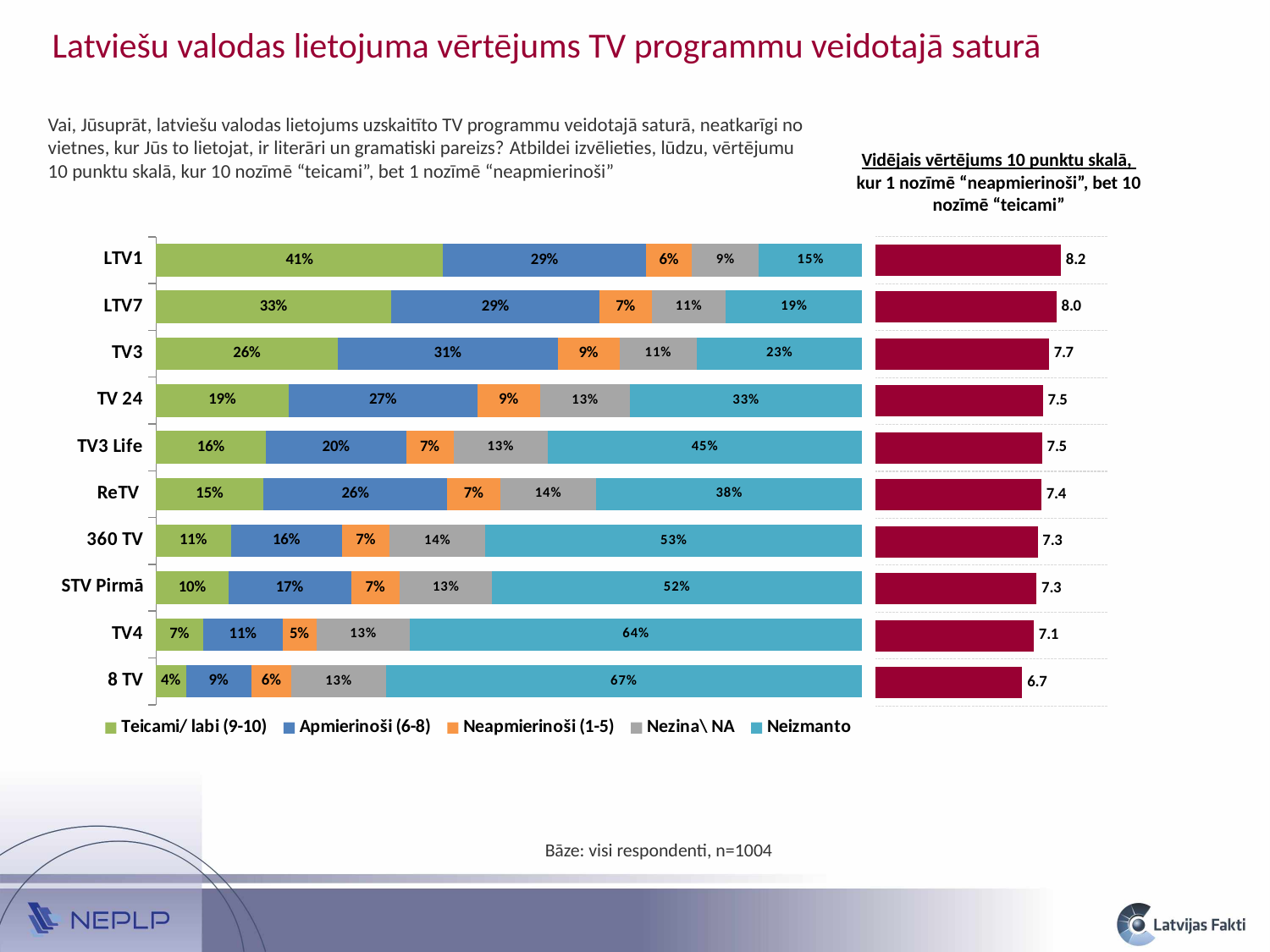
How many series does the legend of the stacked bar chart list? 5 In the stacked bar chart, what percentage of respondents rated LTV1 as "Teicami/ labi (9-10)"? 41% In the right-hand chart of average ratings, which channel has the highest average rating? LTV1 In the stacked bar chart, which legend entry is shown in orange? Neapmierinoši (1-5) In the stacked bar chart, which channel has the larger "Neizmanto" share, TV4 or 8 TV? 8 TV In the right-hand chart of average ratings, what is the difference between the average rating of LTV1 and that of 8 TV? 1.5 In the right-hand chart of average ratings (Vidējais vērtējums 10 punktu skalā), what is the average rating for TV3? 7.7 In the stacked bar chart, which channel has the highest "Neizmanto" share? 8 TV What kind of chart is the left-hand chart on the slide? Stacked bar chart How many TV channels are shown in the stacked bar chart? 10 In the right-hand chart of average ratings, which channel has the lowest average rating? 8 TV In the stacked bar chart, what is the "Neizmanto" share for 360 TV? 53%